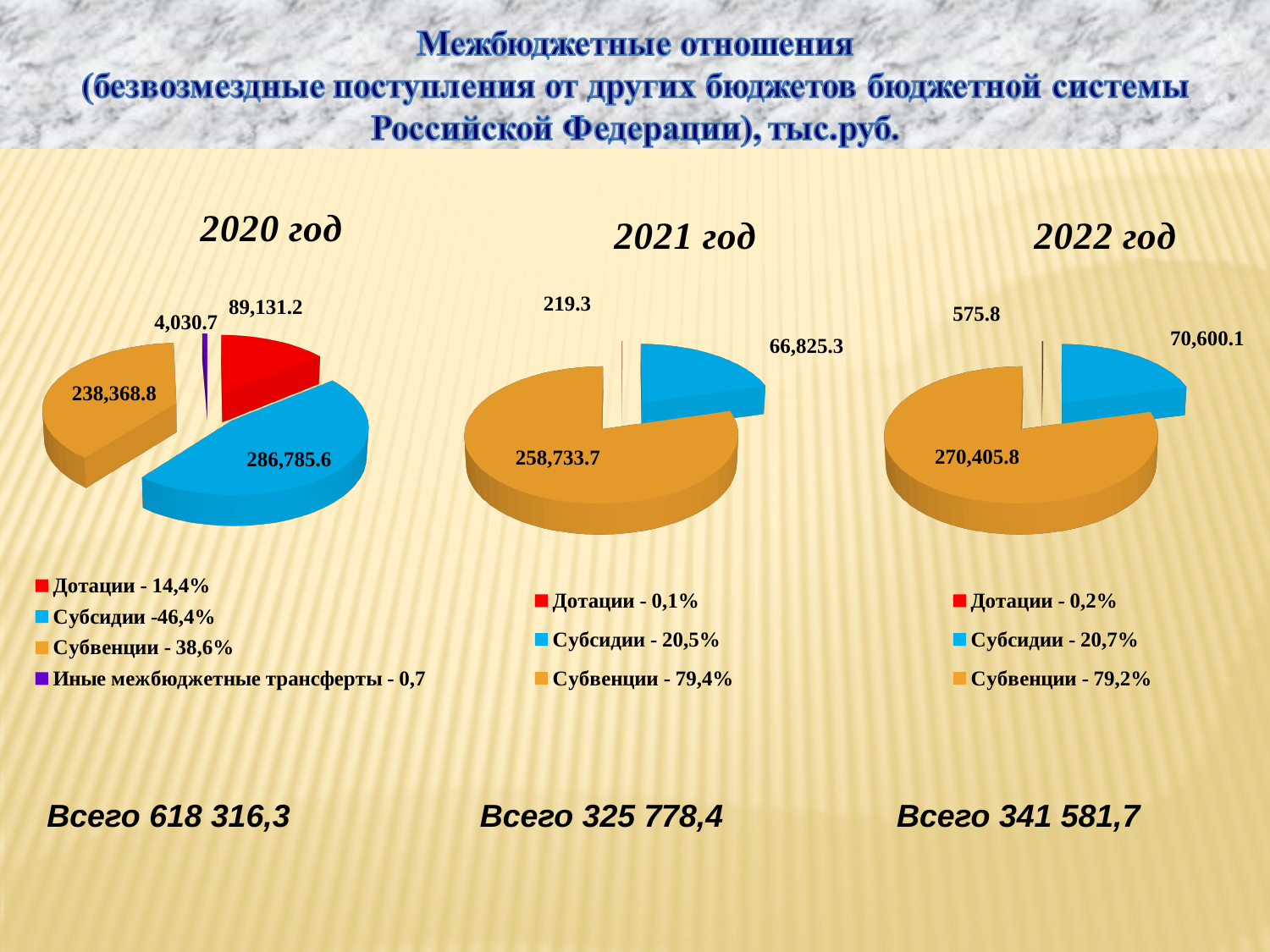
In the 2022 год pie chart, what is the difference between Субвенции and Субсидии? 199,805.7 In the 2022 год pie chart, what is the value for Дотации? 575.8 In the 2021 год pie chart, which is larger: Субсидии or Дотации? Субсидии In the 2020 год pie chart, what is the value for Субсидии? 286,785.6 According to the legend of the 2021 год chart, what share of the pie is Субвенции? 79,4% In the 2022 год pie chart, which category has the largest value? Субвенции In the 2020 год pie chart, which category has the smallest value? Иные межбюджетные трансферты In the 2021 год pie chart, what is the value for Субвенции? 258,733.7 How many categories does the 2020 год pie chart have? 4 In the 2020 год pie chart, which category has the largest value? Субсидии In the 2020 год pie chart, what is the difference between Субсидии and Субвенции? 48,416.8 What type of chart is used for 2021 год? Pie chart